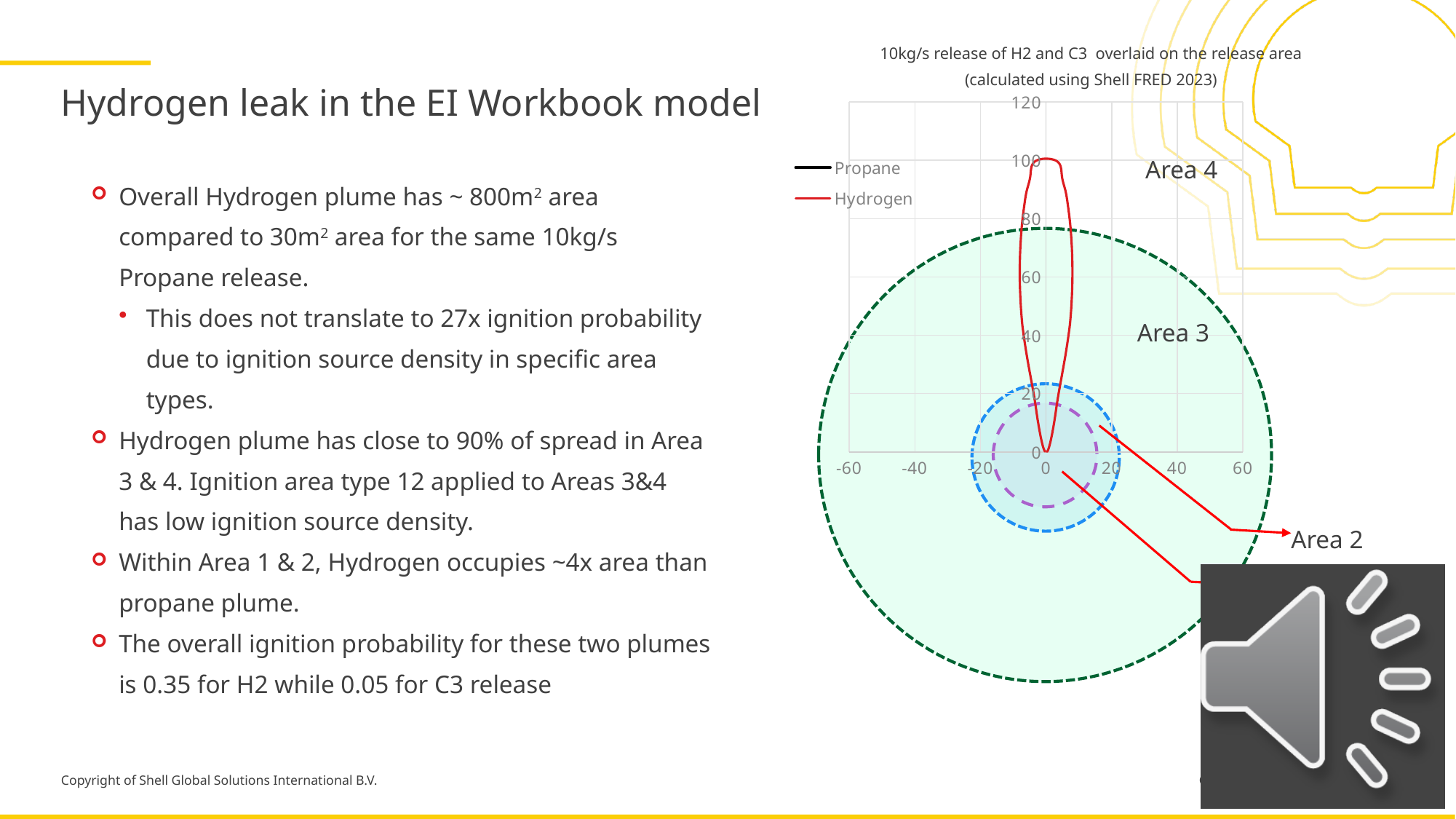
What is the highest value shown on the chart's vertical axis? 120 Is the maximum height reached by the Hydrogen plume outline greater or less than 80 on the vertical axis? greater What is the lowest value shown on the chart's horizontal axis? -60 Is the maximum height reached by the Hydrogen plume outline greater or less than 120 on the vertical axis? less Which software is named in the chart title as used for the calculation? Shell FRED 2023 What release rate is stated in the chart title? 10kg/s Which series, Propane or Hydrogen, extends further up the vertical axis on the chart? Hydrogen What colour is the Hydrogen series drawn in on the chart? Red How many tick labels are shown on the chart's horizontal axis? 7 What are the two series named in the chart legend? Propane and Hydrogen What is the highest value shown on the chart's horizontal axis? 60 How many series does the chart legend list? 2